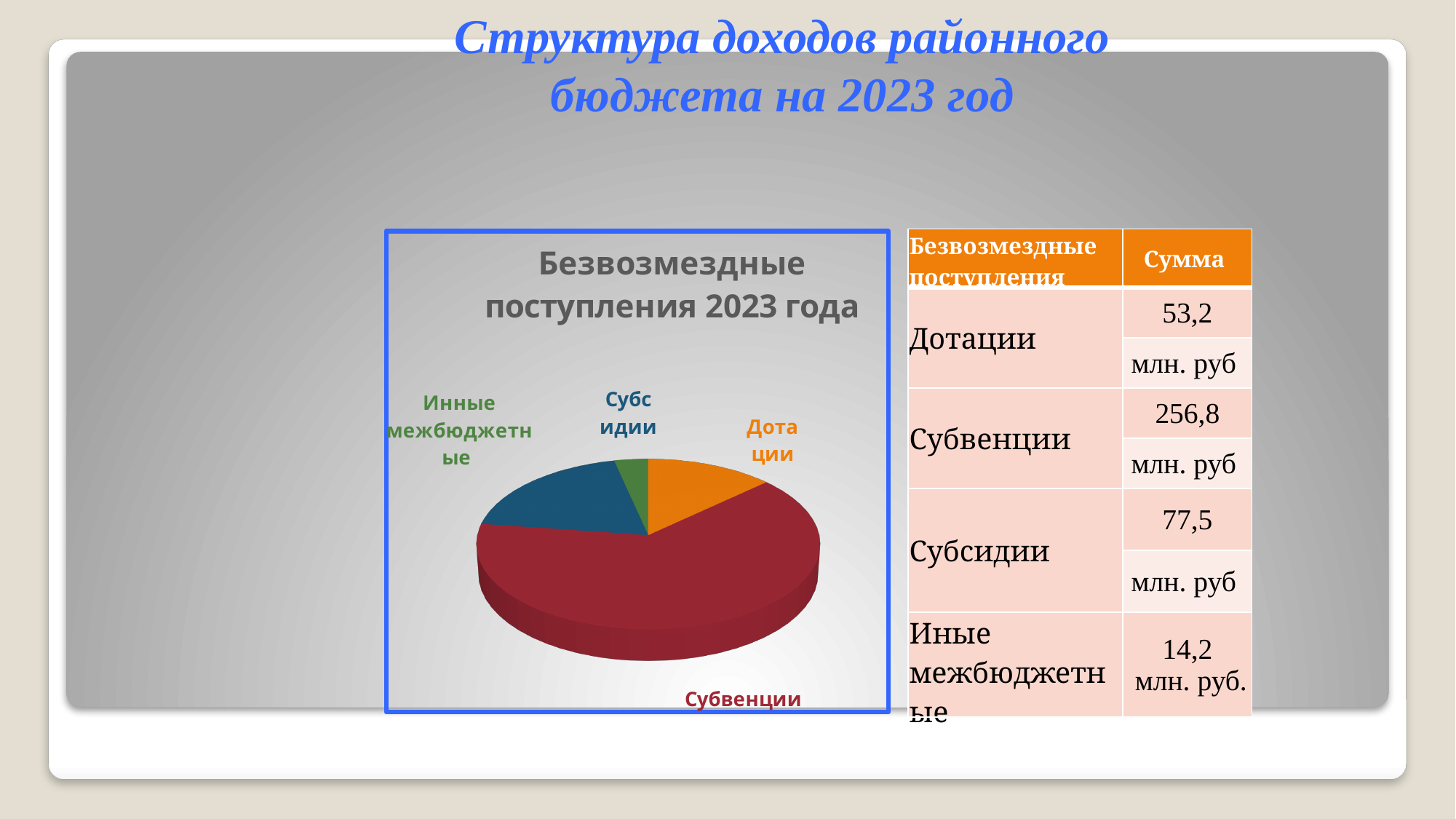
What is the title of the chart? Безвозмездные поступления 2023 года Which category has the largest slice of the pie? Субвенции How many slices does the pie chart have? 4 What colour is the Субвенции slice of the pie? dark red Which is larger, the slice for Субсидии or the slice for Дотации? Субсидии Which category has the smallest slice of the pie? Иные межбюджетные Using the values in the table, how much larger is Субвенции than Дотации? 203,6 млн. руб What is the value for Иные межбюджетные according to the table next to the chart? 14,2 млн. руб. What is the value for Дотации according to the table next to the chart? 53,2 млн. руб Which is larger, the slice for Субвенции or the slice for Субсидии? Субвенции What kind of chart is shown on the slide? pie chart What is the value for Субвенции according to the table next to the chart? 256,8 млн. руб